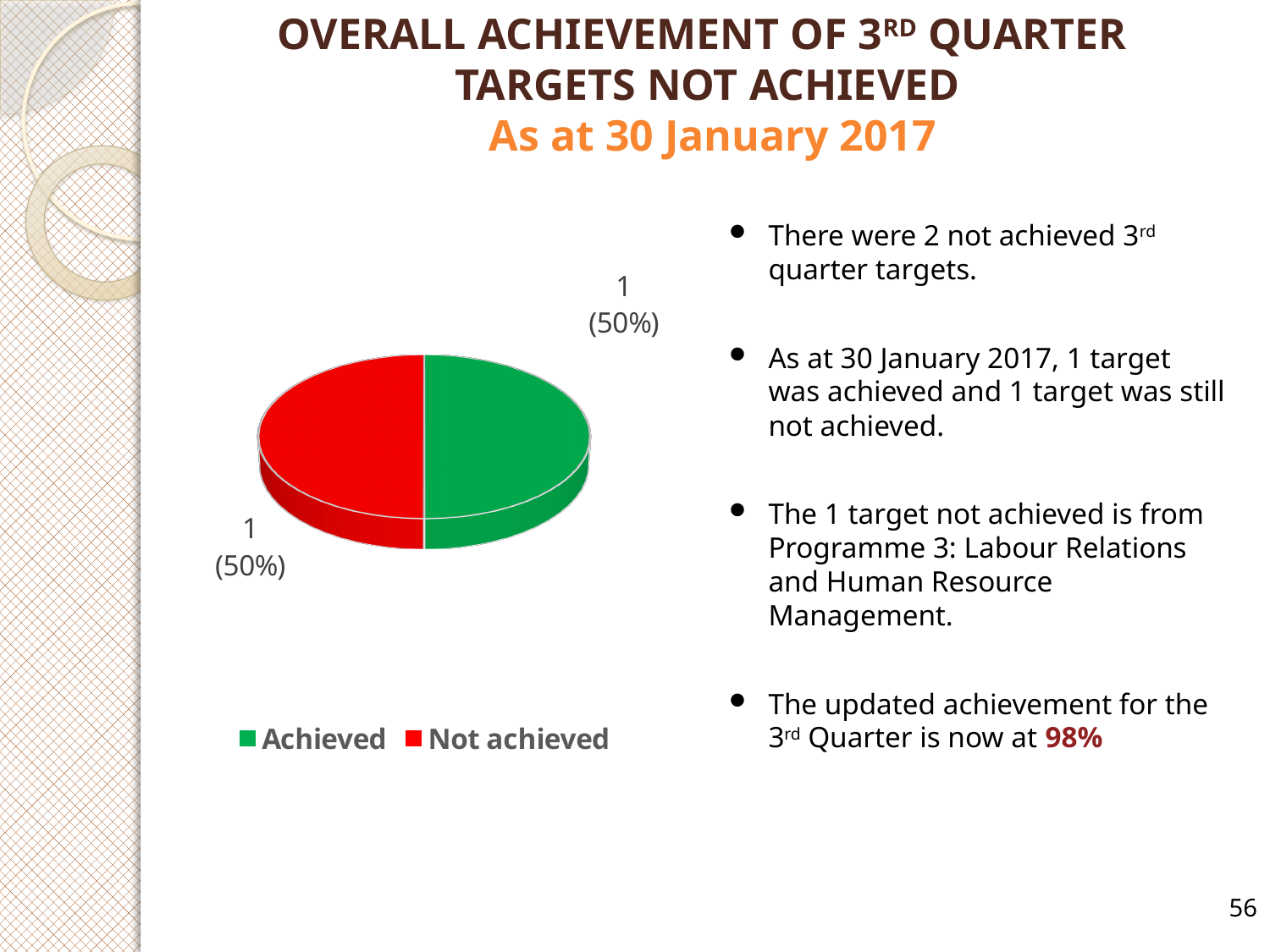
What is the difference between the Achieved and Not achieved values? 0 What share of the pie does the Not achieved slice represent? 50% How many slices does the pie chart have? 2 What is the total of all slices in the pie chart? 2 What kind of chart is shown on the slide? pie chart What share of the pie does the Achieved slice represent? 50% How many entries does the legend of the pie chart list? 2 What is the value shown for the Not achieved slice? 1 Which colour represents the Achieved slice? green What is the value shown for the Achieved slice? 1 Which colour represents the Not achieved slice? red